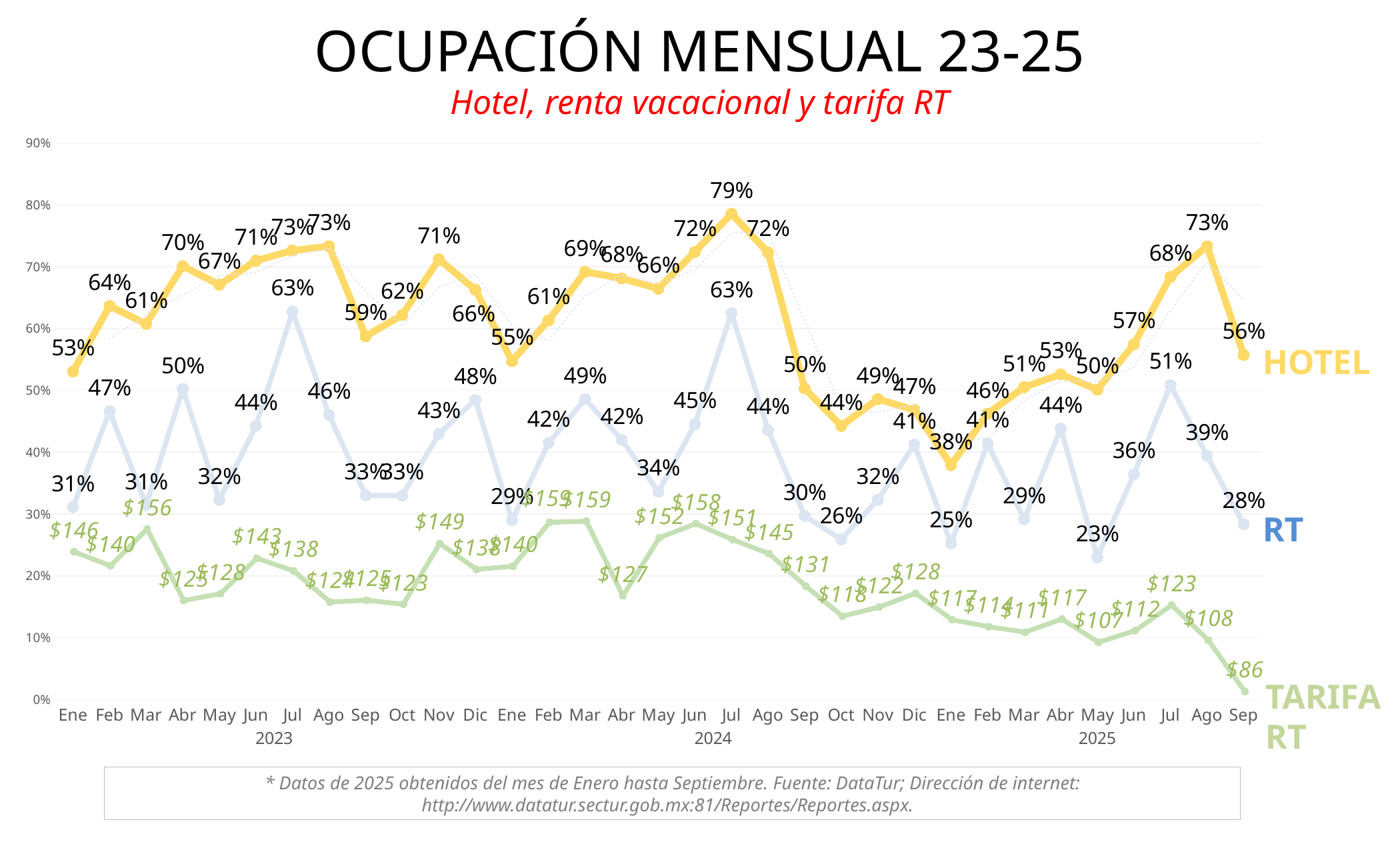
How many series are plotted on the chart? 3 What is the TARIFA RT value for Mar 2023? $156 How many monthly data points does each series have? 33 What is the HOTEL occupancy value for Jul 2024? 79% What is the difference between the HOTEL values for Ago 2025 and Sep 2025? 17 percentage points In which month does the HOTEL series reach its highest value? Jul 2024 In which month does the TARIFA RT series reach its lowest value? Sep 2025 Which is larger in Ene 2023, the HOTEL value or the RT value? HOTEL What is the RT occupancy value for May 2025? 23% Does the HOTEL series rise or fall from Jun 2025 to Ago 2025? Rise Is the RT value for Oct 2024 greater or less than 30%? less What kind of chart is shown on the slide? Line chart